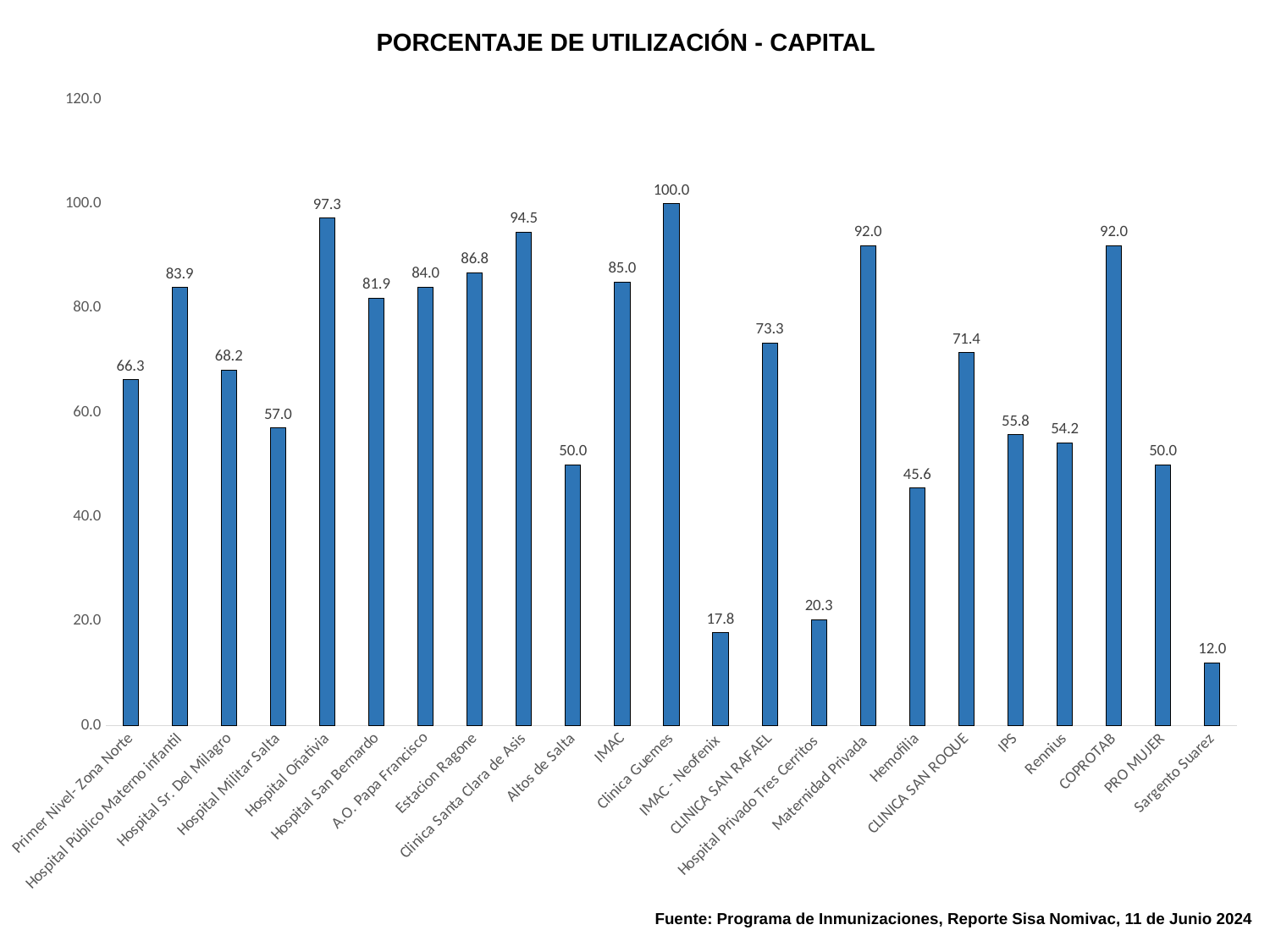
How many categories are shown on the x axis? 23 What is the value for IMAC - Neofenix? 17.8 What is the value for CLINICA SAN RAFAEL? 73.3 What kind of chart is shown on the slide? bar chart What is the value for Hemofilia? 45.6 What is the difference between the values for Clinica Guemes and Sargento Suarez? 88.0 Which category has the lowest value? Sargento Suarez What is the value for Hospital Oñativia? 97.3 Is the value for Hospital Privado Tres Cerritos greater or less than 40.0? less Which category has the highest value? Clinica Guemes Which is larger, the value for Estacion Ragone or the value for IMAC? Estacion Ragone What is the difference between the values for Hospital Público Materno infantil and Hospital Militar Salta? 26.9